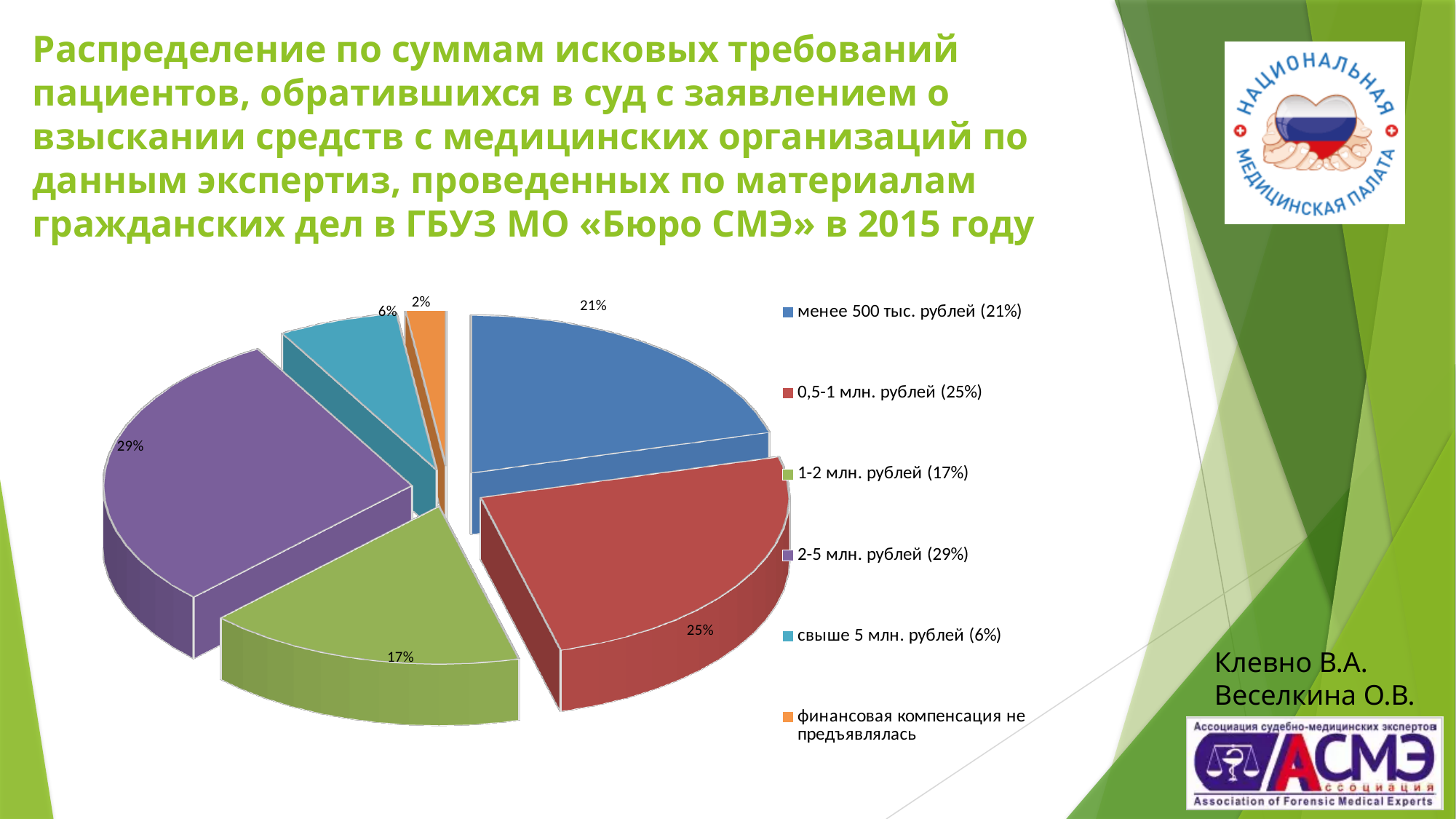
What share of the pie does the slice "финансовая компенсация не предъявлялась" represent? 2% What share of the pie does the slice "1-2 млн. рублей" represent? 17% What share of the pie does the slice "менее 500 тыс. рублей" represent? 21% What colour is the slice for "2-5 млн. рублей"? purple What is the difference in percentage points between the shares of "2-5 млн. рублей" and "1-2 млн. рублей"? 12 Which category has the smallest share of the pie? финансовая компенсация не предъявлялась Which category has the largest share of the pie? 2-5 млн. рублей How many categories does the pie chart show? 6 Which share is larger: "0,5-1 млн. рублей" or "менее 500 тыс. рублей"? 0,5-1 млн. рублей What kind of chart is shown on the slide? pie chart